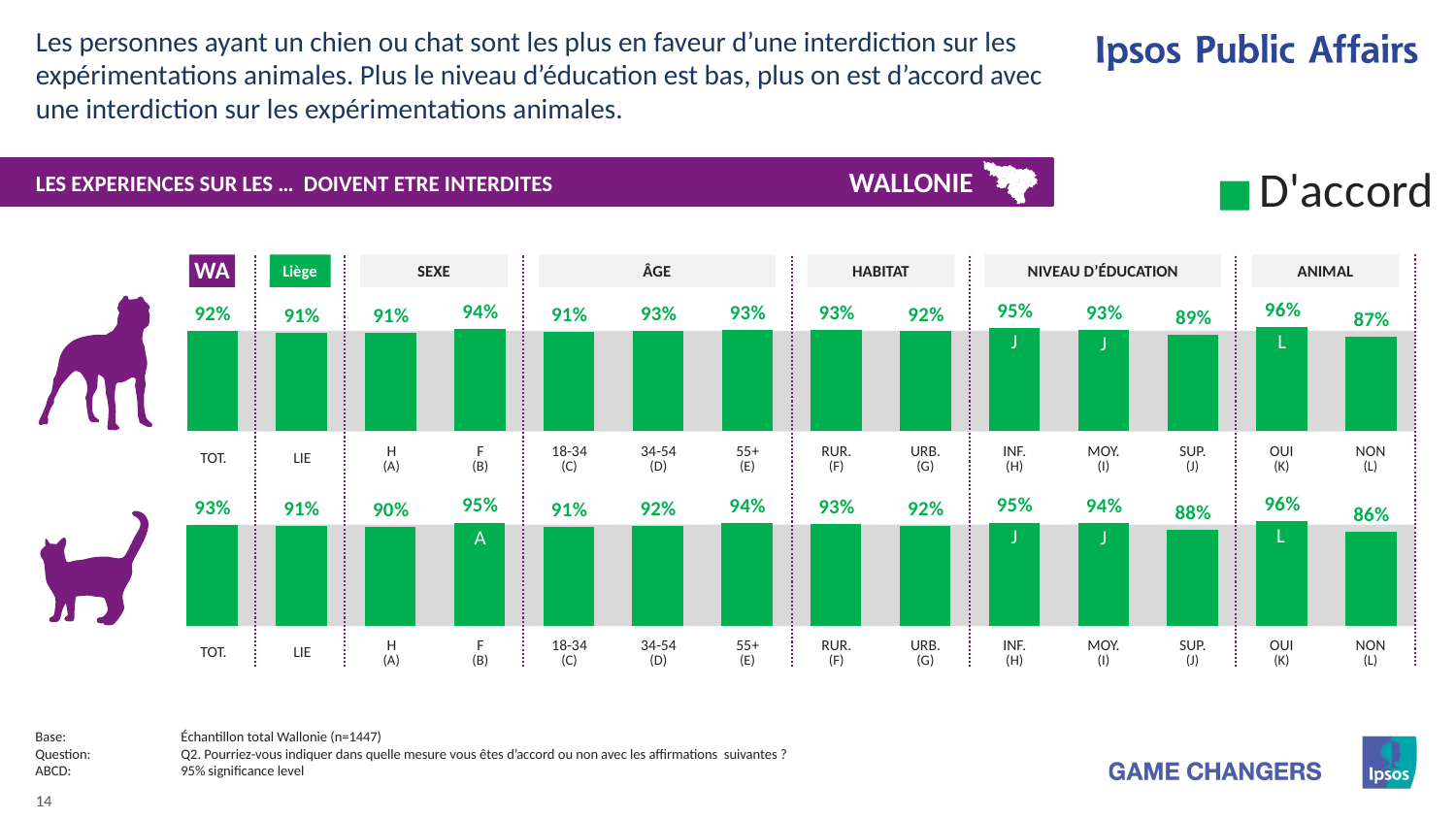
How many bars are in the top row (dog)? 14 In the bottom row of bars (cat), what is the value for SUP. (J) under NIVEAU D'ÉDUCATION? 88% In the bottom row of bars (cat), which is larger, the value for 18-34 (C) or 55+ (E)? 55+ (E) In the top row of bars (dog), which is larger, the value for RUR. (F) or URB. (G)? RUR. (F) In the bottom row of bars (cat), what is the value for TOT.? 93% In the top row of bars (dog), what is the value for NON (L) under ANIMAL? 87% In the bottom row of bars (cat), which category has the lowest value? NON (L) In the top row of bars (dog), which category has the highest value? OUI (K) In the top row of bars (dog), what is the difference between INF. (H) and SUP. (J)? 6% What kind of chart is used on this slide? Bar chart In the bottom row of bars (cat), what is the difference between F (B) and H (A)? 5% In the top row of bars (dog), what is the value for TOT.? 92%